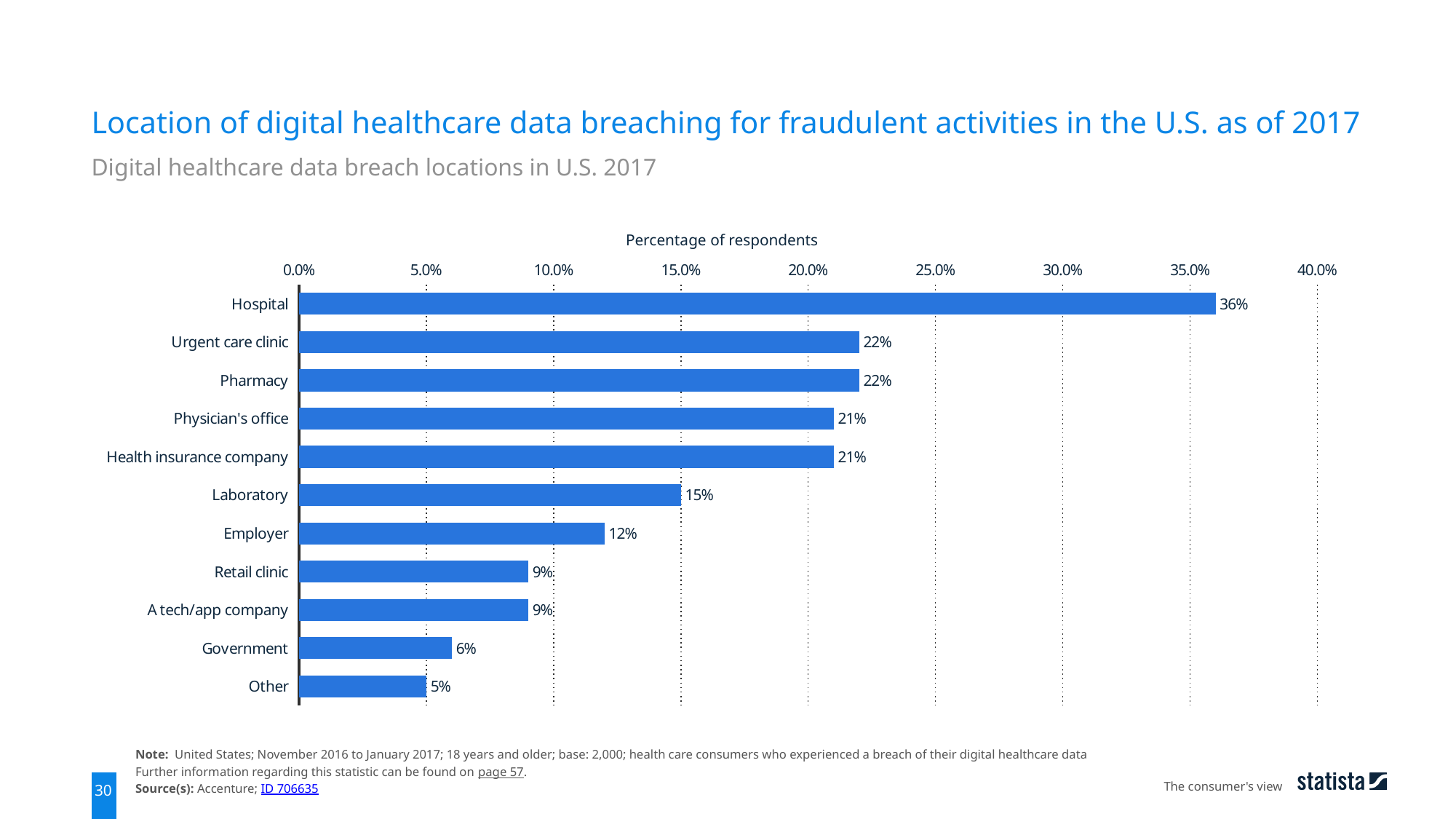
What percentage of respondents reported Hospital as the location of the data breach? 36% What is the value for Government? 6% Is the value for Physician's office greater or less than 20.0%? greater What kind of chart is shown on the slide? Bar chart How many locations are shown in the chart? 11 What is the difference between the values for Hospital and Urgent care clinic? 14% What is the difference between the values for Employer and Retail clinic? 3% Which location has the lowest percentage of respondents? Other What is the label of the horizontal axis? Percentage of respondents Which location has the highest percentage of respondents? Hospital Which is larger, the value for Laboratory or the value for Employer? Laboratory What is the value for Laboratory? 15%